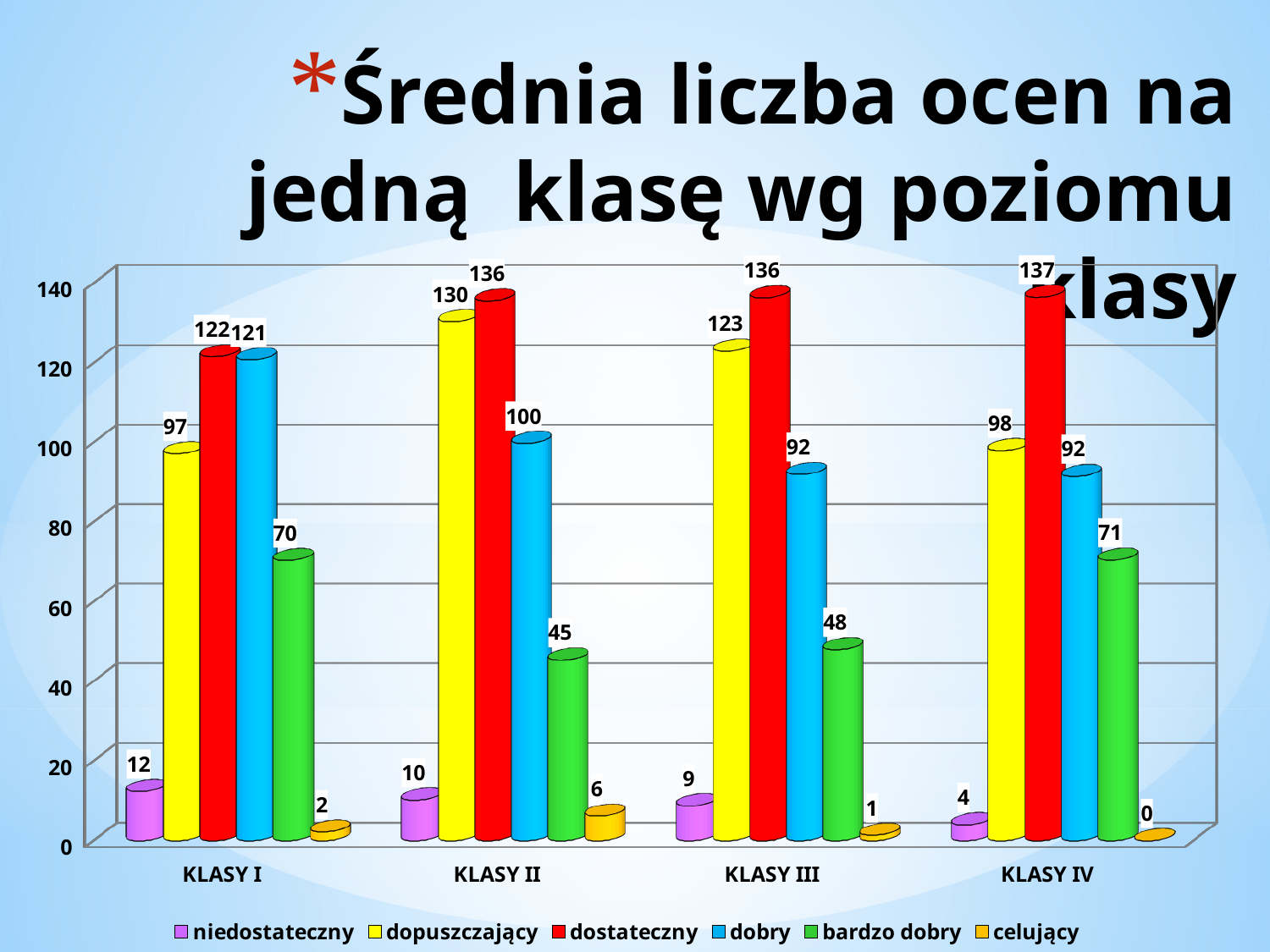
What kind of chart is shown on the slide? bar chart What is the value for bardzo dobry in KLASY II? 45 What is the value for dobry in KLASY I? 121 How many series does the legend list? 6 Which is larger: bardzo dobry in KLASY I or bardzo dobry in KLASY IV? KLASY IV How many classes (categories) are shown on the x axis? 4 What is the difference between the dobry values for KLASY II and KLASY III? 8 What is the value for dostateczny in KLASY IV? 137 What is the value for celujący in KLASY IV? 0 Which class has the highest value for dopuszczający? KLASY II Which colour represents the dostateczny series? red Which class has the lowest value for niedostateczny? KLASY IV